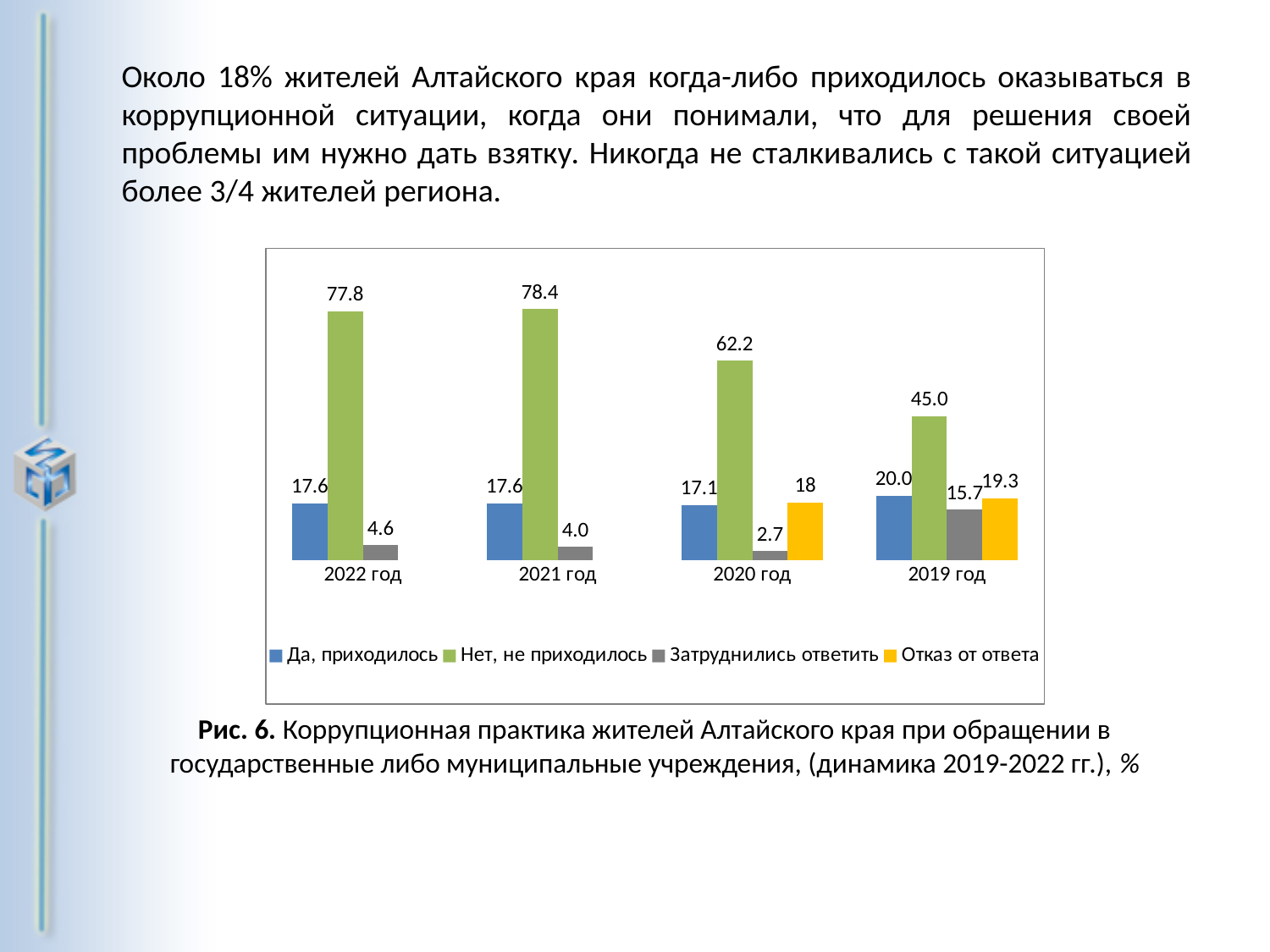
Which is larger: "Затруднились ответить" in 2022 год or in 2019 год? 2019 год How many years (categories) are shown on the x axis? 4 What is the value for "Затруднились ответить" in 2020 год? 2.7 In which year is the value for "Нет, не приходилось" the highest? 2021 год How many series does the legend list? 4 In which year is the value for "Нет, не приходилось" the lowest? 2019 год What is the value for "Нет, не приходилось" in 2021 год? 78.4 What is the value for "Отказ от ответа" in 2019 год? 19.3 What is the difference between the "Нет, не приходилось" values for 2021 год and 2020 год? 16.2 What colour are the bars for "Отказ от ответа"? Yellow What is the value for "Да, приходилось" in 2019 год? 20.0 What kind of chart is shown on the slide? Bar chart